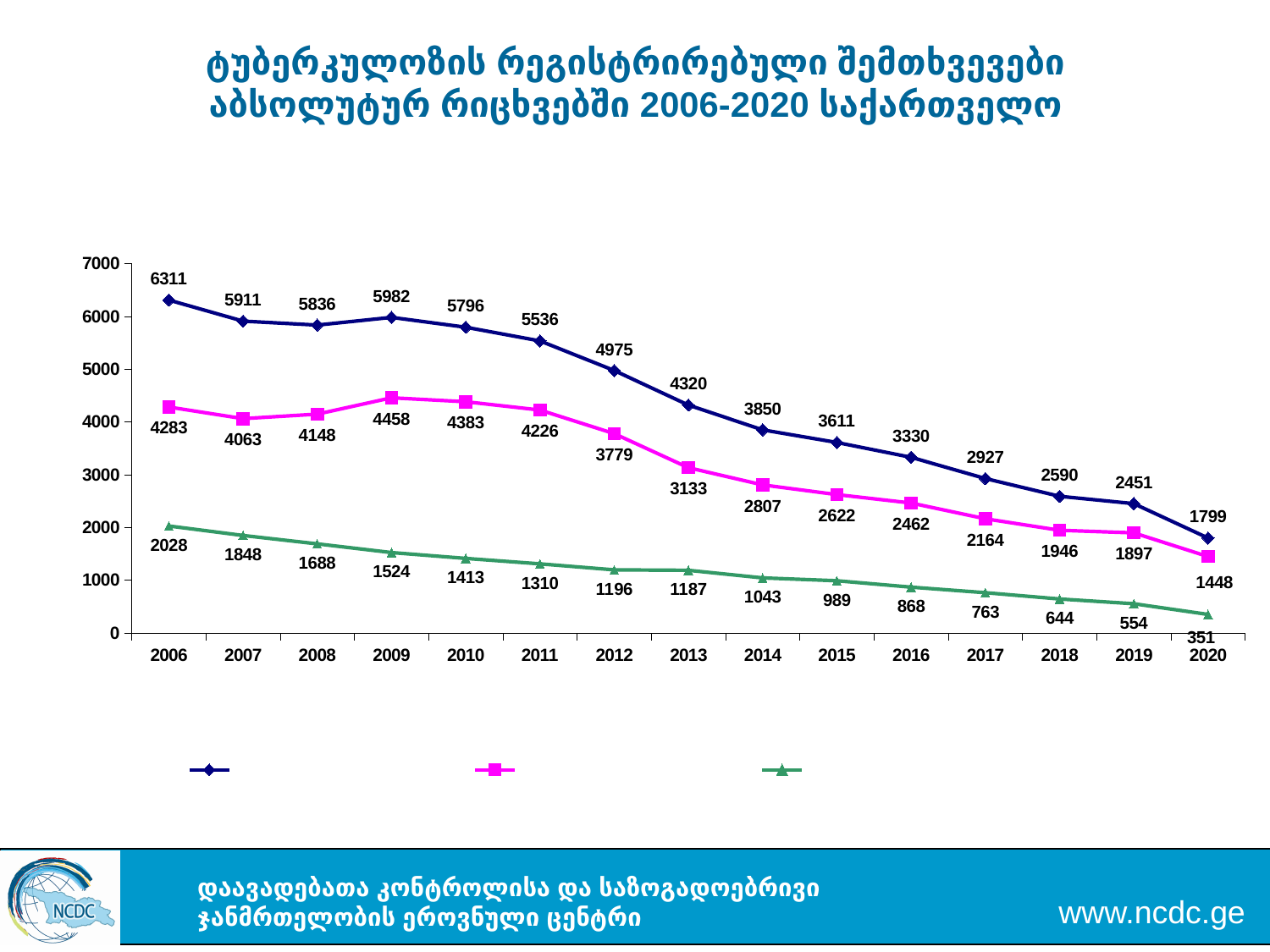
In which year does the dark blue diamond series reach its highest value? 2006 How many series does the legend show? 3 By how much did the dark blue diamond series decrease from 2006 to 2020? 4512 In which year does the green triangle series reach its lowest value? 2020 What is the value of the magenta square series in 2013? 3133 What is the value of the green triangle series in 2020? 351 What is the difference between the magenta square series values in 2019 and 2020? 449 What kind of chart is shown on the slide? line chart For the magenta square series, which year has the larger value, 2009 or 2010? 2009 How many years are shown on the x axis? 15 What is the value of the dark blue diamond series in 2006? 6311 Does the dark blue diamond series rise or fall from 2006 to 2020? fall